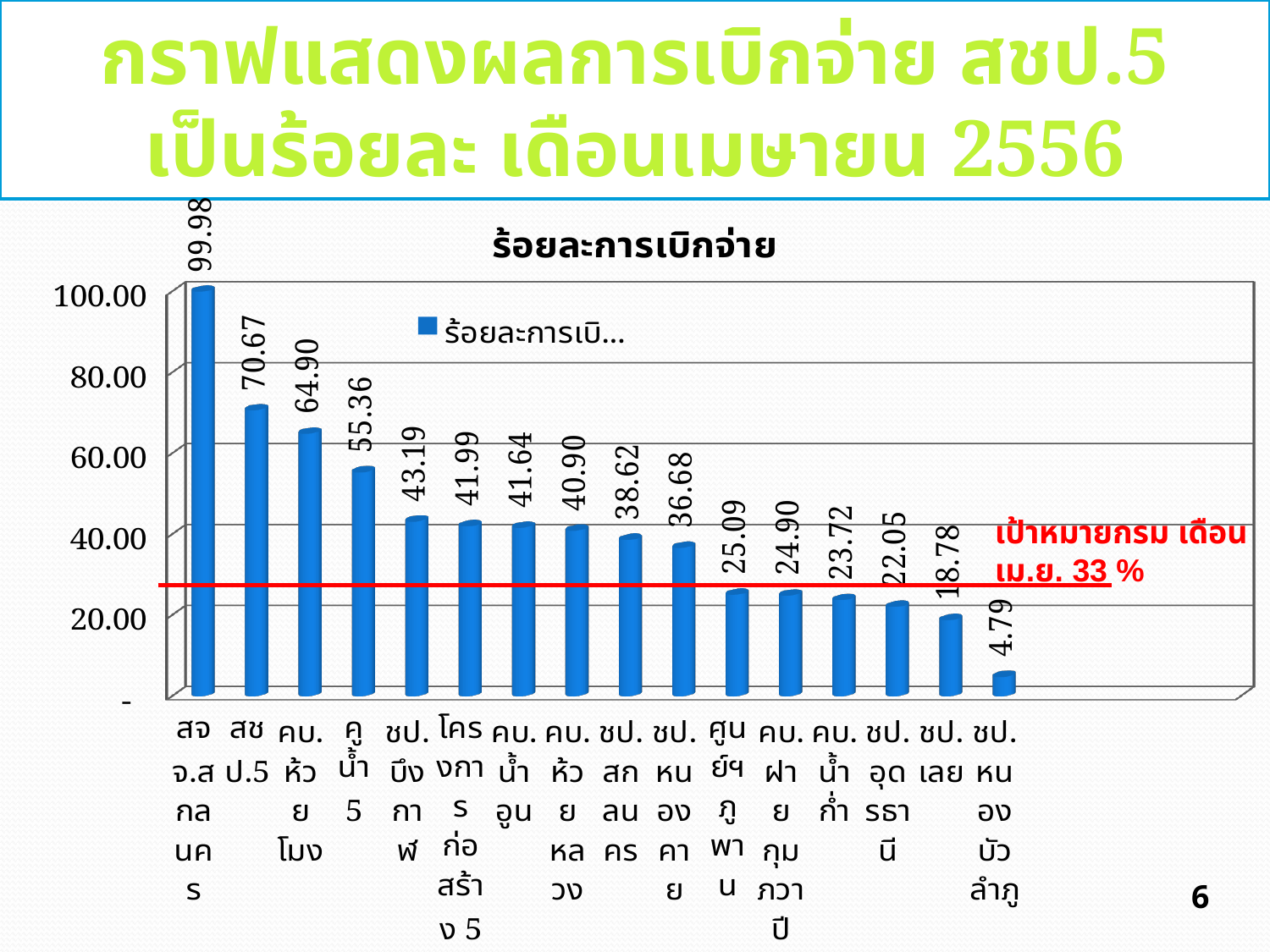
What type of chart is shown on the slide? bar chart What is the value for คบ.น้ำอูน? 41.64 Which is larger, the value for คบ.ห้วยโมง or the value for คูน้ำ 5? คบ.ห้วยโมง How many categories are shown on the x axis? 16 What target percentage does the red horizontal line represent, according to its label? 33 % What is the difference between the values for สจจ.สกลนคร and สชป.5? 29.31 What is the value for ชป.เลย? 18.78 What is the value for สชป.5? 70.67 Do the values rise or fall from left to right along the x axis? fall Which category has the lowest value? ชป.หนองบัวลำภู Is the value for ชป.อุดรธานี greater or less than 40.00? less Which category has the highest value? สจจ.สกลนคร